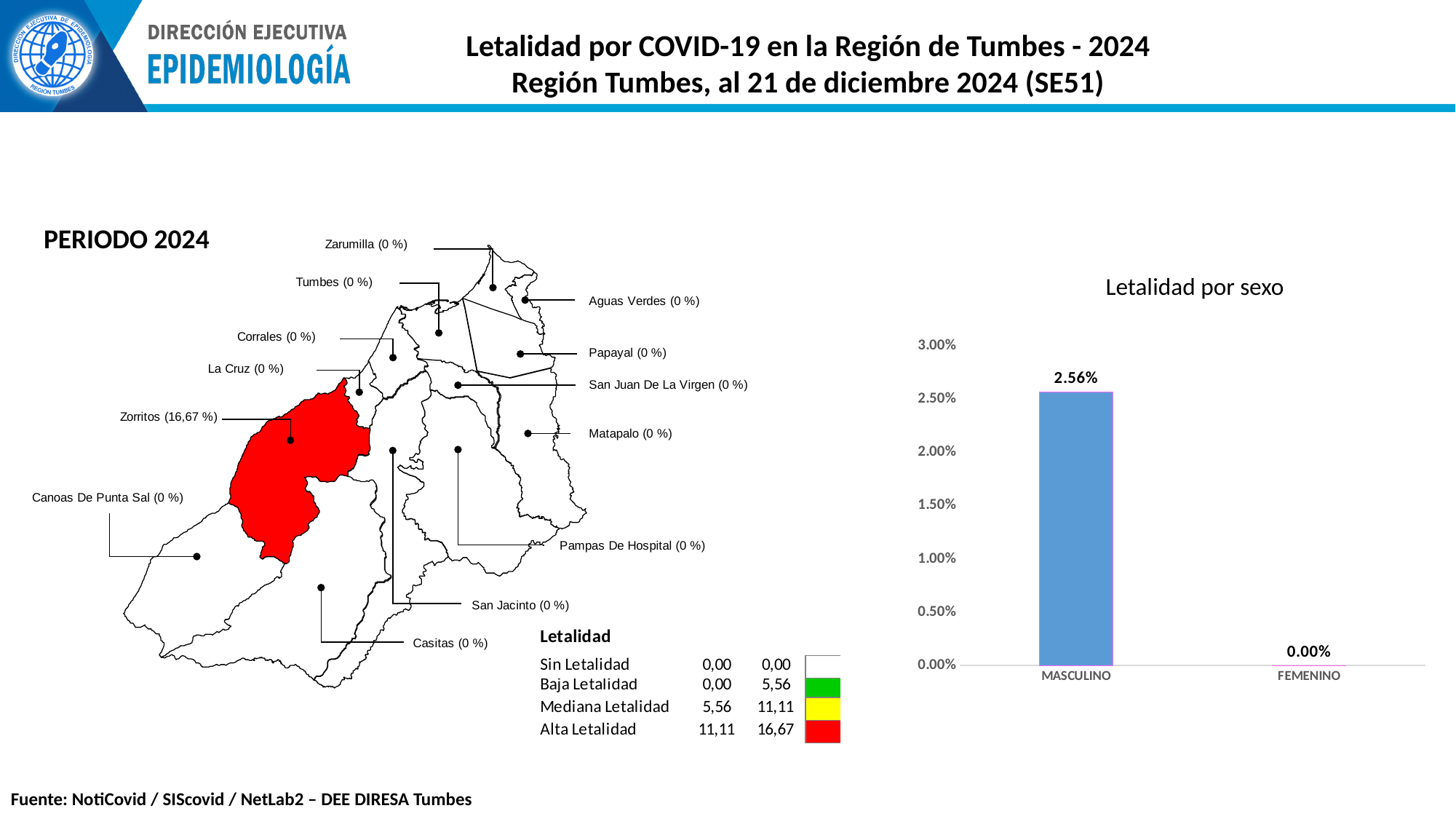
What is the highest tick value shown on the vertical axis of the 'Letalidad por sexo' chart? 3.00% In the 'Letalidad por sexo' chart, which is larger, the value for MASCULINO or for FEMENINO? MASCULINO In the 'Letalidad por sexo' chart, what is the value for MASCULINO? 2.56% On the map on the left, what is the lethality value shown for Zorritos? 16,67 % What kind of chart is the 'Letalidad por sexo' chart? bar chart In the 'Letalidad por sexo' chart, which category has the lowest value? FEMENINO How many categories are shown in the 'Letalidad por sexo' chart? 2 In the 'Letalidad por sexo' chart, which category has the highest value? MASCULINO In the 'Letalidad por sexo' chart, is the value for MASCULINO greater or less than 2.00%? greater In the 'Letalidad por sexo' chart, what is the difference between the MASCULINO and FEMENINO values? 2.56% In the 'Letalidad por sexo' chart, is the value for MASCULINO greater or less than 3.00%? less In the 'Letalidad por sexo' chart, what is the value for FEMENINO? 0.00%